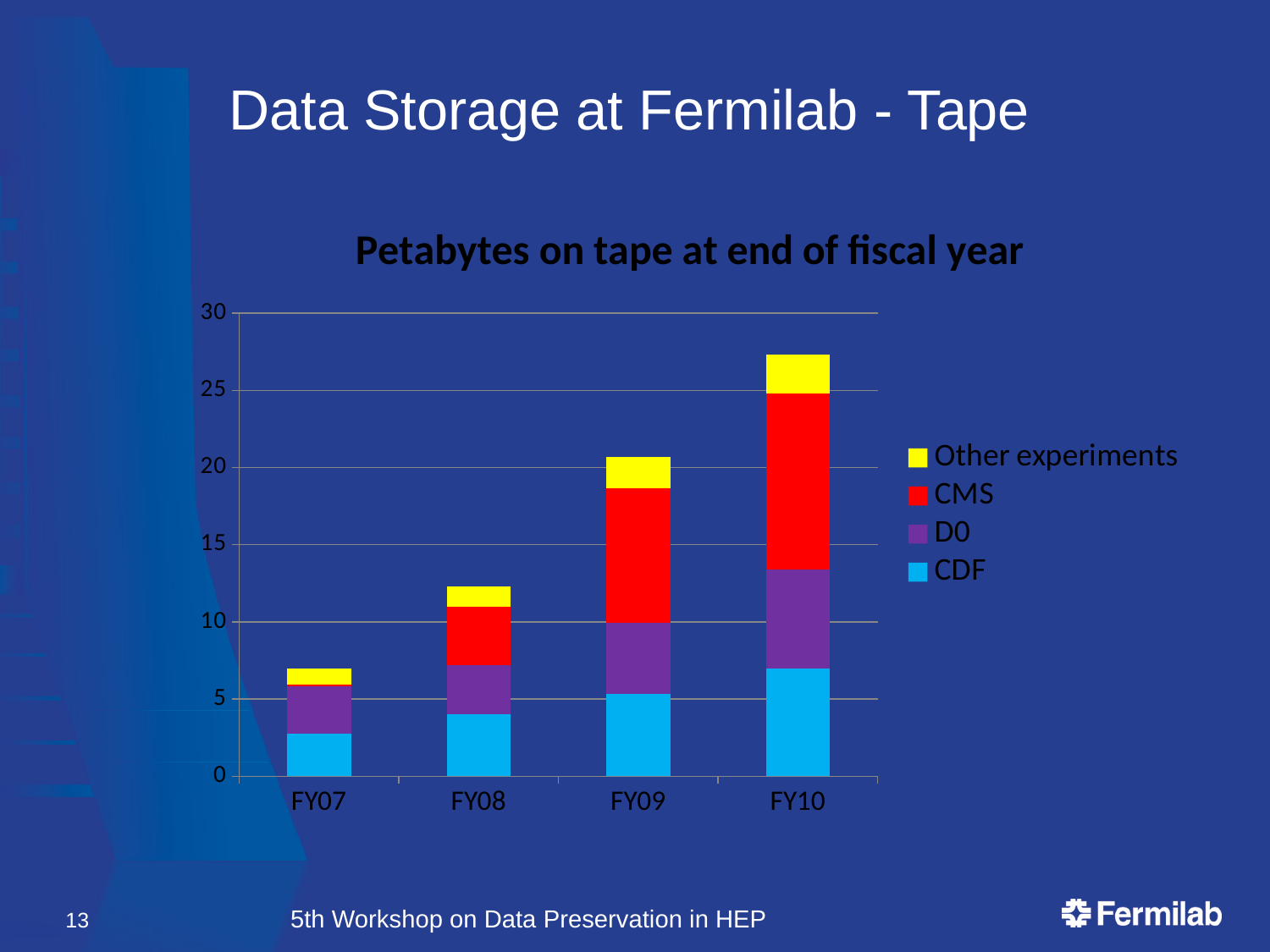
Is the total value for FY07 greater or less than 10? less Do the total petabytes on tape rise or fall from FY07 to FY10? rise How many series does the chart legend list? 4 How many fiscal years are shown on the x axis of the chart? 4 In FY10, which is larger, the CMS segment or the D0 segment? CMS Is the CDF value for FY10 greater or less than 5? greater What kind of chart is shown on the slide? stacked bar chart What is the title of the chart? Petabytes on tape at end of fiscal year Is the total value for FY08 greater or less than 10? greater Which fiscal year has the lowest total petabytes on tape? FY07 Which fiscal year has the highest total petabytes on tape? FY10